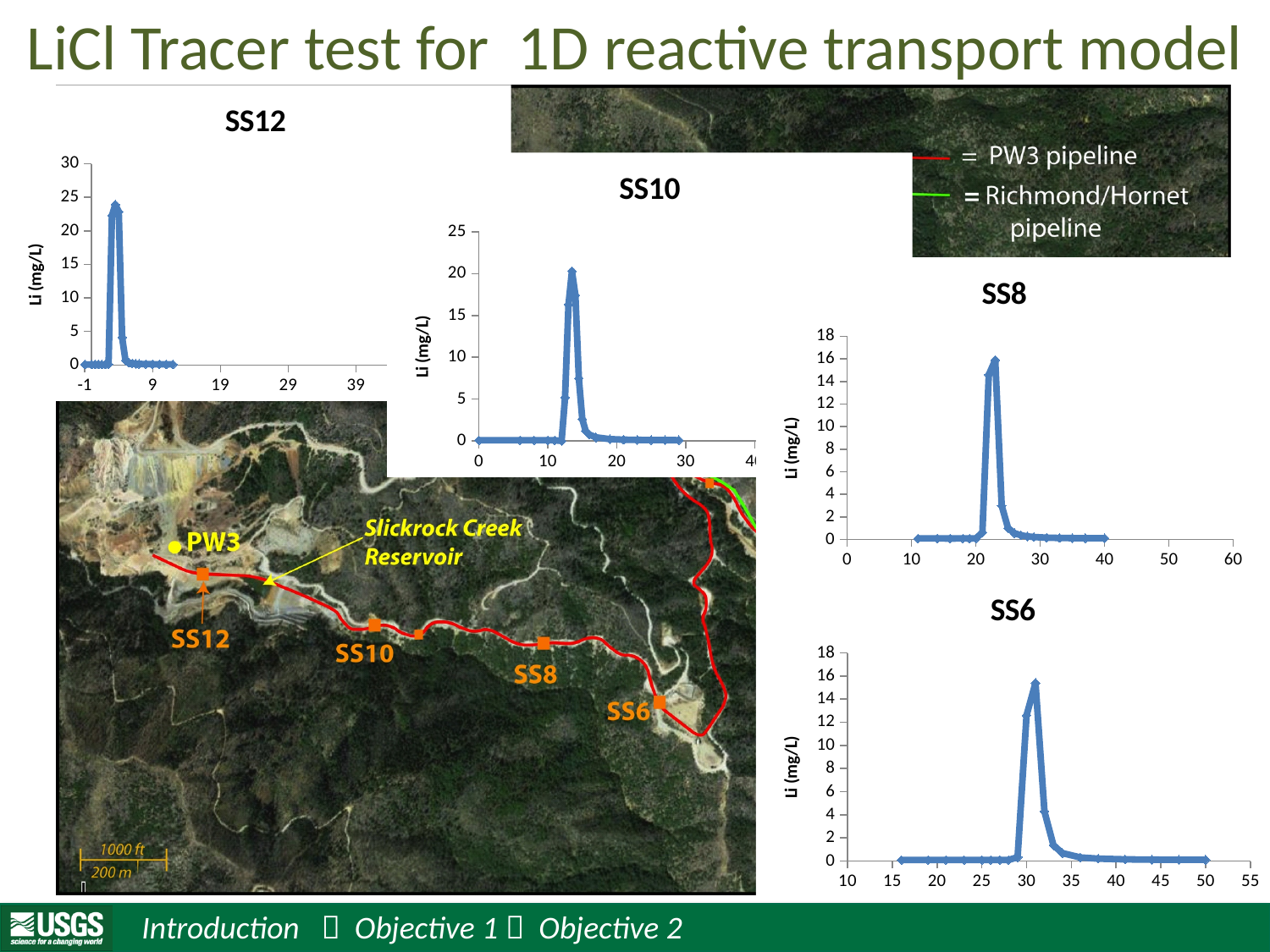
In the SS6 chart, do the values rise or fall along the x axis between 31 and 40? fall In the SS10 chart, is the peak value greater or less than 15? greater In the SS8 chart, is the peak value greater or less than 10? greater What is the largest x-axis tick value shown on the SS8 chart? 60 In the SS6 chart, is the peak value greater or less than 10? greater What kind of chart is the SS12 chart? line chart Which chart has the higher peak, SS12 or SS8? SS12 Of the four charts SS12, SS10, SS8 and SS6, which has the highest peak? SS12 Which chart has the higher peak, SS10 or SS6? SS10 What is the y-axis label on the SS8 chart? Li (mg/L)